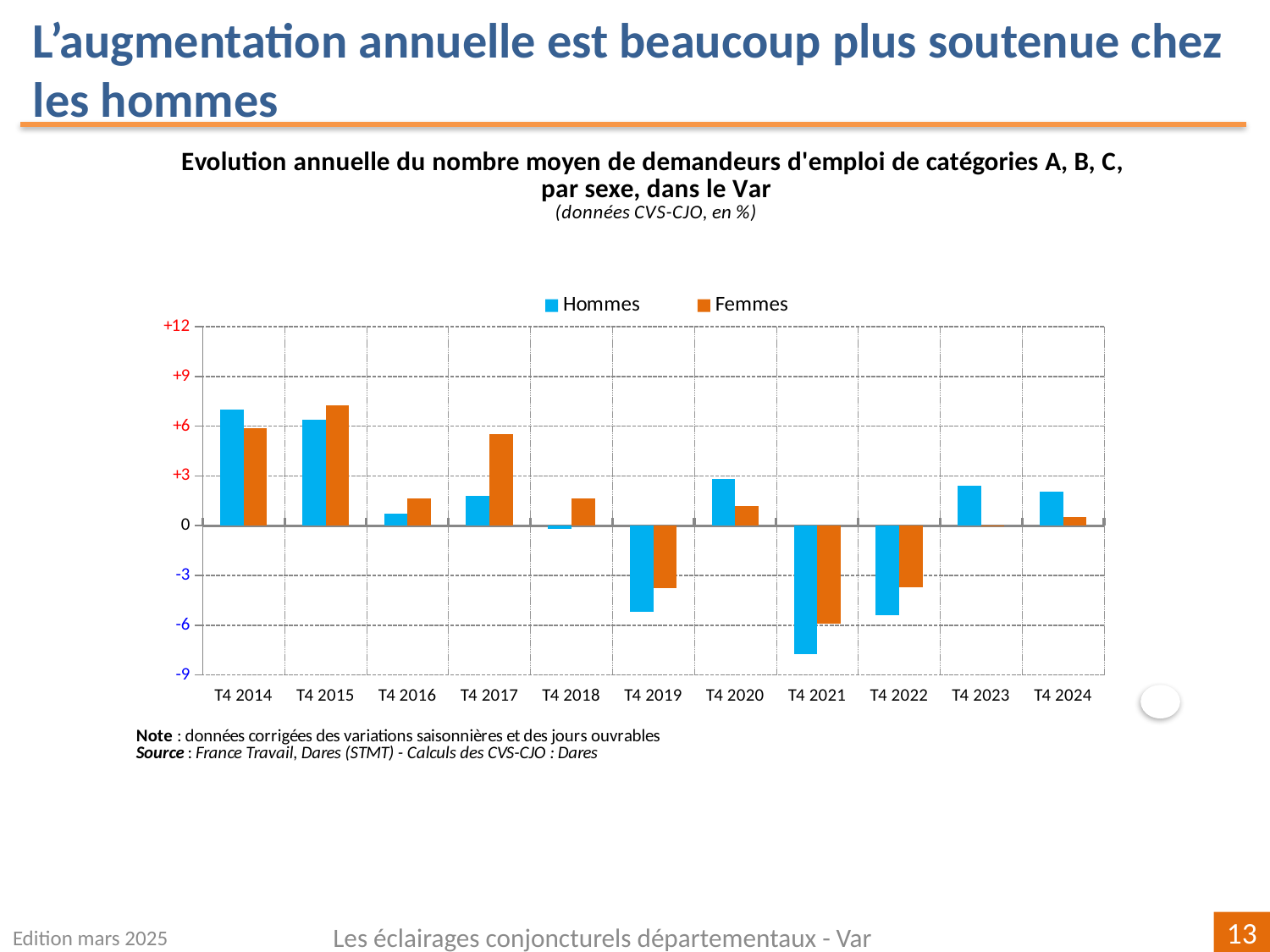
Which colour represents the Hommes series in the legend? Blue In T4 2017, which series has the larger value, Hommes or Femmes? Femmes Is the Femmes value for T4 2017 greater or less than +3? greater In which quarter is the Femmes value highest? T4 2015 Is the Hommes value for T4 2021 greater or less than -6? less How many series does the legend list? 2 How many quarters (categories) are shown on the x axis? 11 In which quarter is the Femmes value lowest? T4 2021 What kind of chart is shown on the slide? Bar chart In which quarter is the Hommes value lowest? T4 2021 In T4 2020, which series has the larger value, Hommes or Femmes? Hommes In which quarter is the Hommes value highest? T4 2014